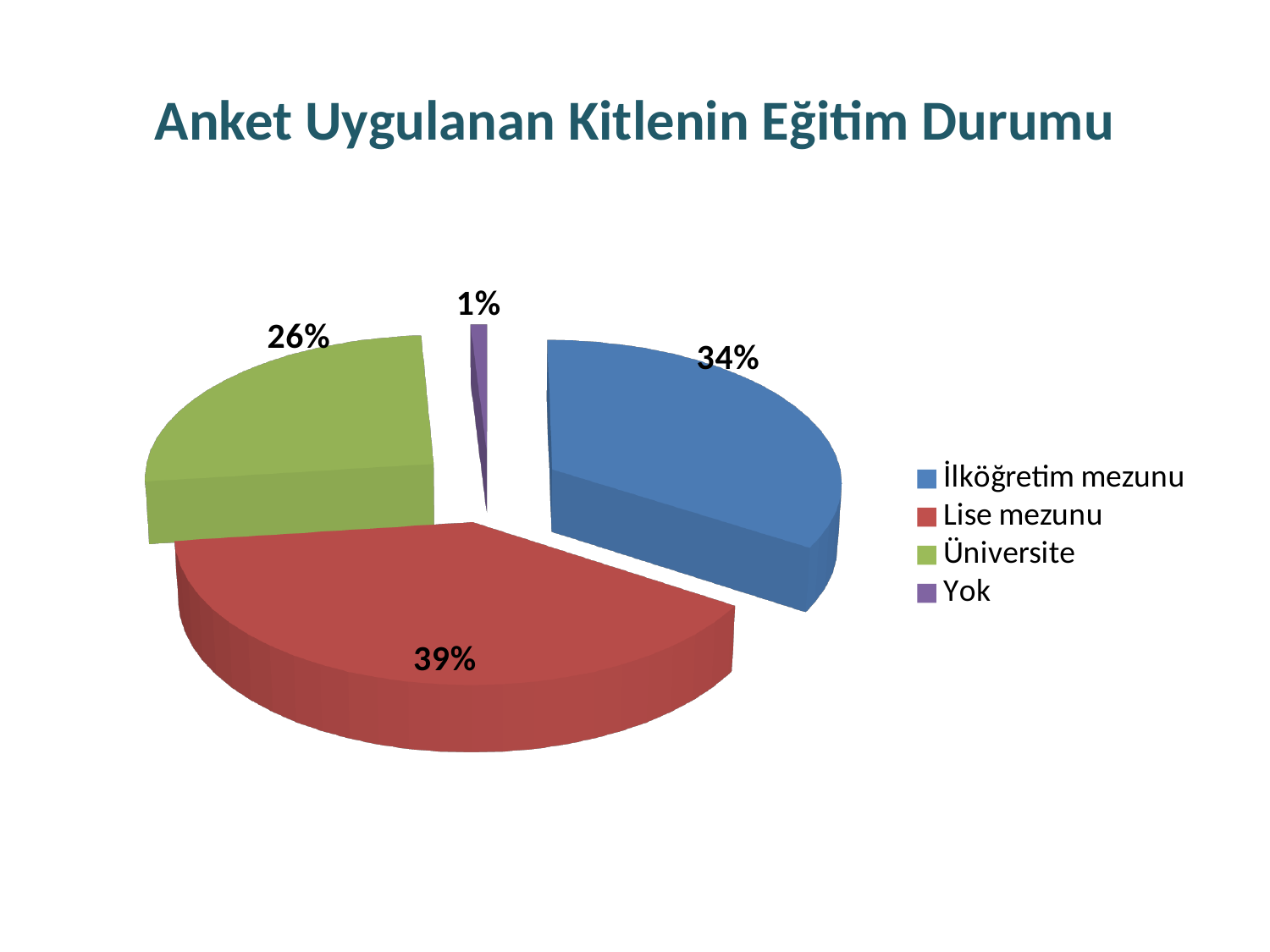
What share of the pie does Lise mezunu have? 39% Which category has the largest share of the pie? Lise mezunu What share of the pie does Üniversite have? 26% Which category has the smallest share of the pie? Yok How many categories does the pie chart have? 4 What share of the pie does Yok have? 1% Which colour represents Üniversite in the legend? Green What is the difference in percentage points between Lise mezunu and Üniversite? 13 What is the title of the chart? Anket Uygulanan Kitlenin Eğitim Durumu Which is larger, the share for İlköğretim mezunu or the share for Üniversite? İlköğretim mezunu What type of chart is shown on the slide? Pie chart